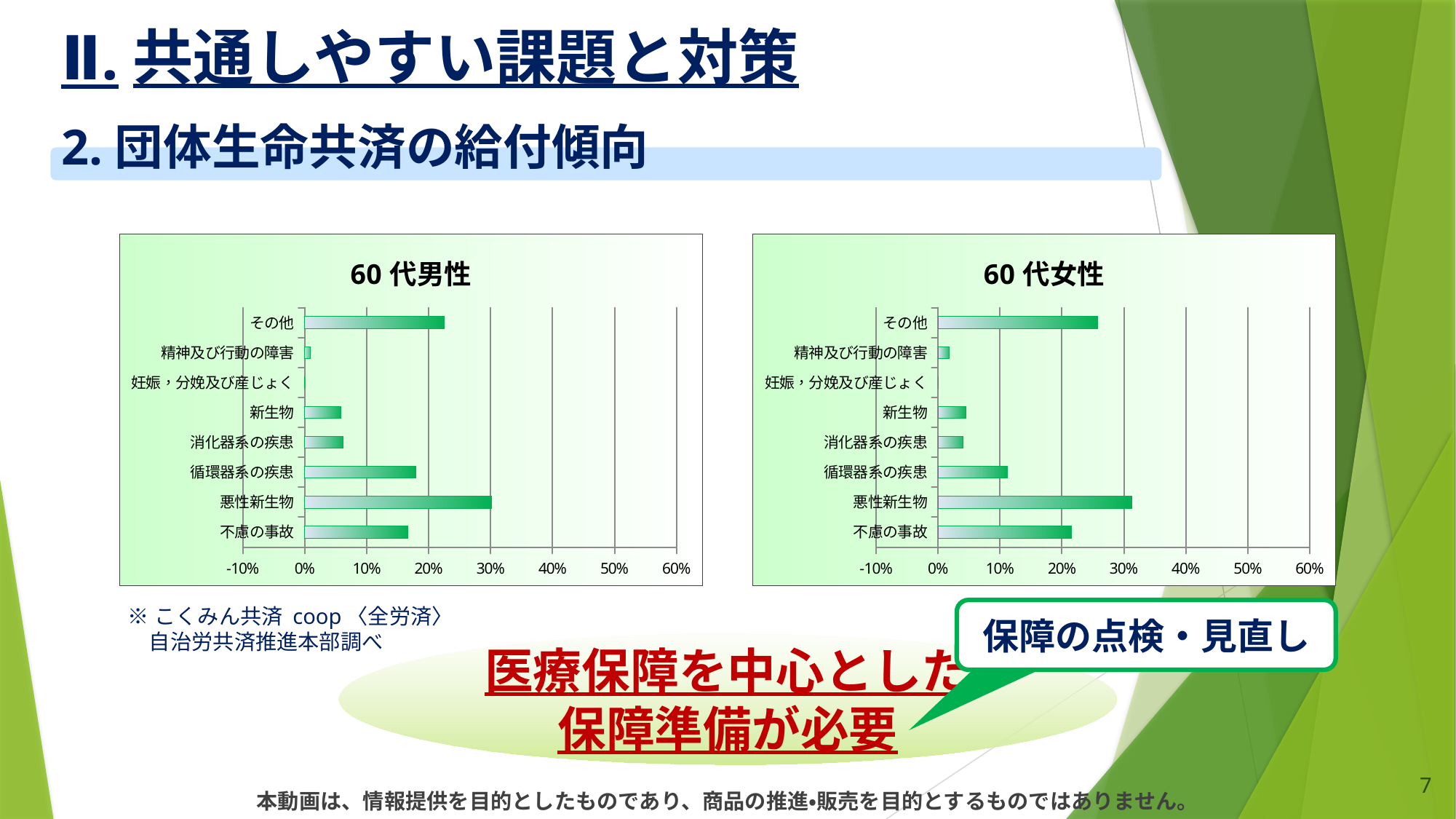
In the 60 代男性 chart, which is larger, the value for 循環器系の疾患 or the value for 消化器系の疾患? 循環器系の疾患 In the 60 代男性 chart, is the value for 新生物 greater or less than 10%? less What kind of chart is the 60 代男性 chart? bar chart What is the title of the chart on the left side of the slide? 60 代男性 In the 60 代女性 chart, is the value for 不慮の事故 greater or less than 10%? greater In the 60 代男性 chart, which category has the highest value? 悪性新生物 How many categories are listed on the y axis of the 60 代女性 chart? 8 In the 60 代女性 chart, is the value for 精神及び行動の障害 greater or less than 10%? less What is the highest value shown on the x axis of the 60 代女性 chart? 60% In the 60 代女性 chart, which is larger, the value for その他 or the value for 循環器系の疾患? その他 In the 60 代女性 chart, which category has the highest value? 悪性新生物